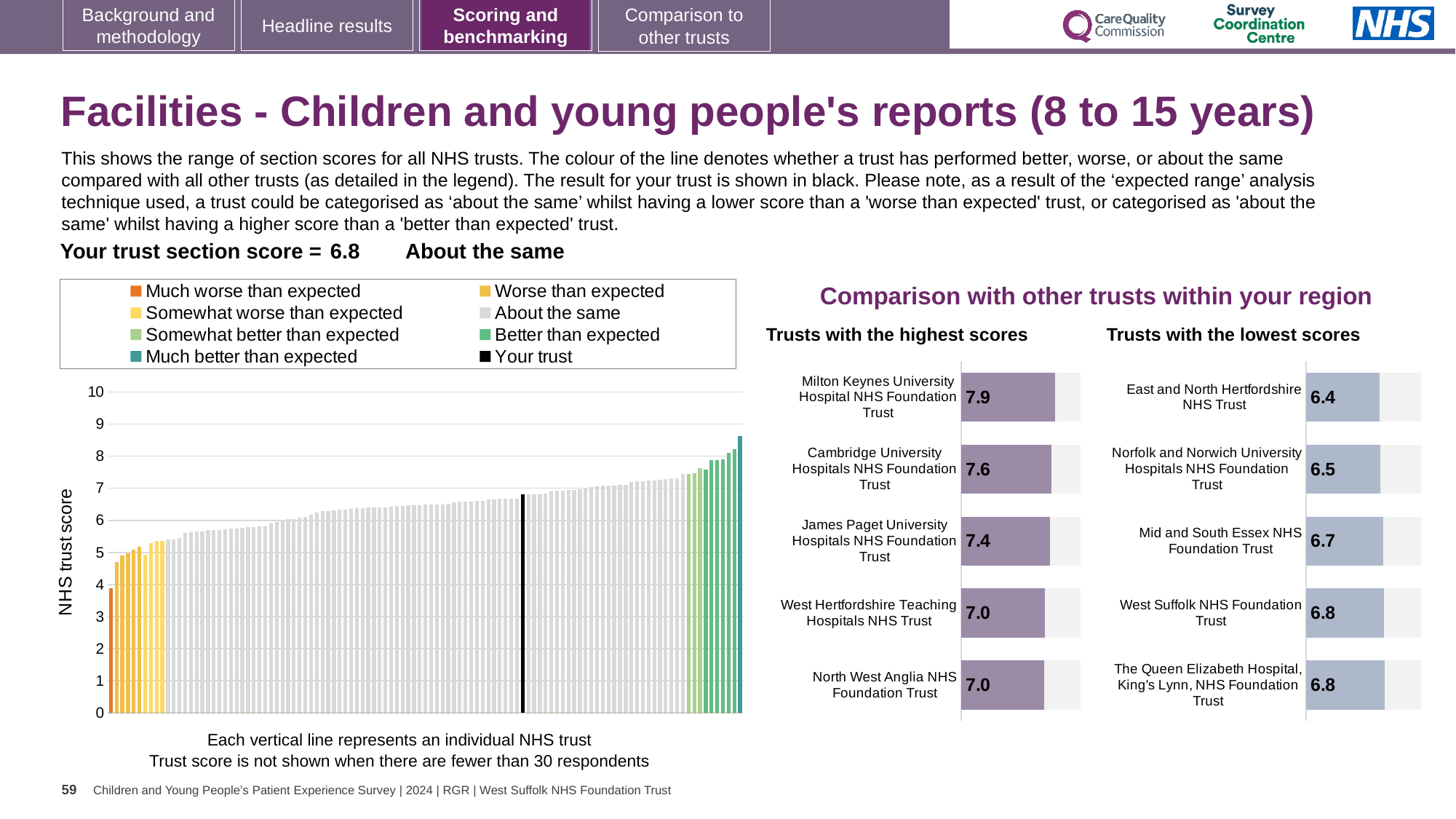
In the 'Trusts with the highest scores' chart, which trust has the highest score? Milton Keynes University Hospital NHS Foundation Trust In the 'Trusts with the highest scores' chart, what is the score for James Paget University Hospitals NHS Foundation Trust? 7.4 In the 'NHS trust score' chart on the left, do the bar values rise or fall from left to right? Rise In the 'Trusts with the lowest scores' chart, what is the difference between the scores of West Suffolk NHS Foundation Trust and East and North Hertfordshire NHS Trust? 0.4 How many entries does the legend of the 'NHS trust score' chart on the left list? 8 What kind of chart is the large 'NHS trust score' chart on the left of the slide? Bar chart In the 'Trusts with the lowest scores' chart, which has the higher score: Norfolk and Norwich University Hospitals NHS Foundation Trust or Mid and South Essex NHS Foundation Trust? Mid and South Essex NHS Foundation Trust In the 'Trusts with the highest scores' chart, what is the difference between the scores of Milton Keynes University Hospital NHS Foundation Trust and Cambridge University Hospitals NHS Foundation Trust? 0.3 How many trusts are shown in the 'Trusts with the highest scores' chart? 5 In the 'Trusts with the highest scores' chart, what is the score for Milton Keynes University Hospital NHS Foundation Trust? 7.9 In the 'Trusts with the lowest scores' chart, what is the score for Norfolk and Norwich University Hospitals NHS Foundation Trust? 6.5 In the 'Trusts with the lowest scores' chart, which trust has the lowest score? East and North Hertfordshire NHS Trust